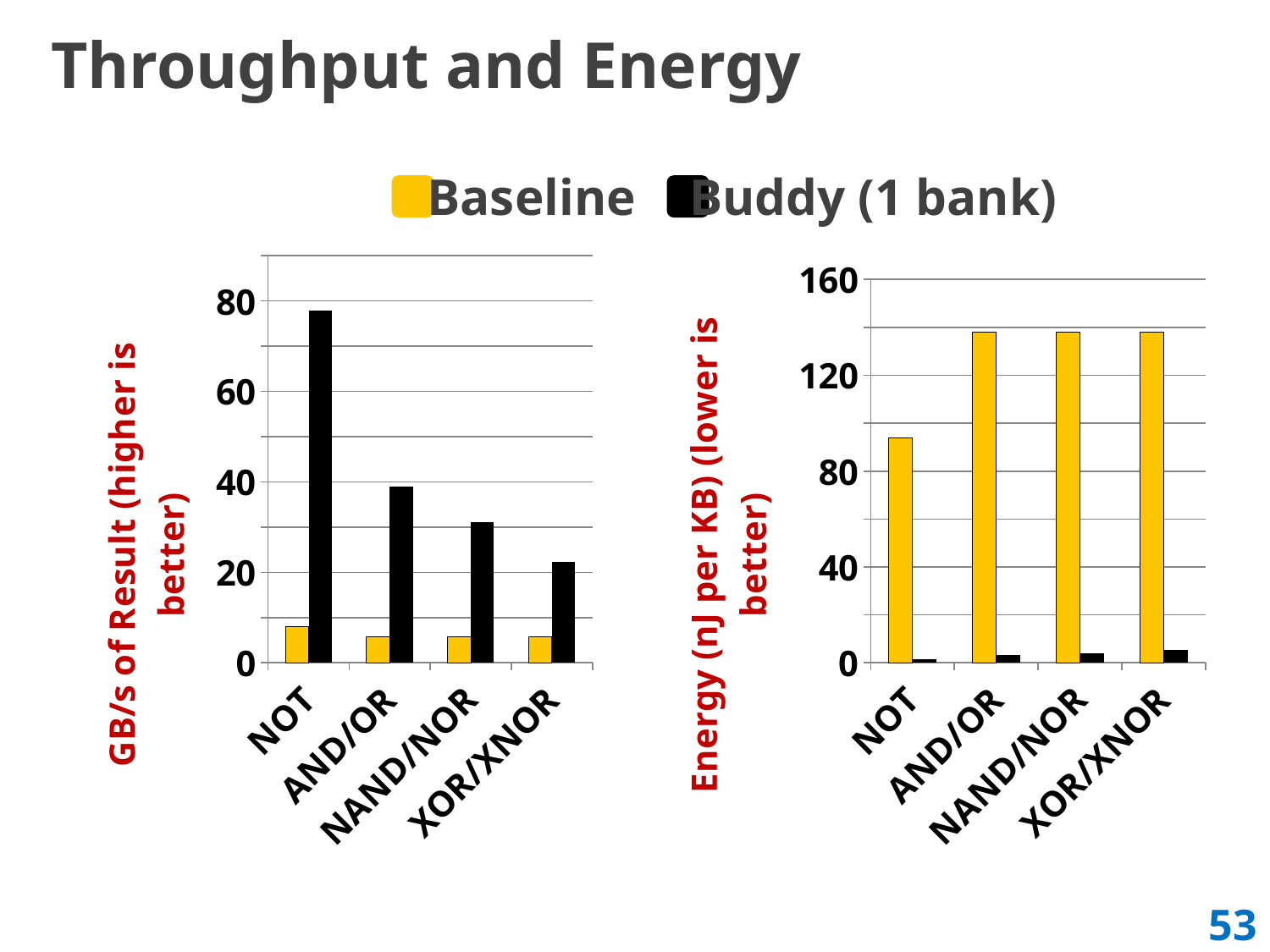
What kind of chart is the left chart (GB/s of Result)? bar chart How many series does the legend list? 2 In the left chart (GB/s of Result), is the Buddy (1 bank) value for XOR/XNOR greater or less than 40? less In the left chart (GB/s of Result), which category has the lowest Buddy (1 bank) value? XOR/XNOR In the right chart (Energy), is the Baseline value for NOT greater or less than 120? less In the right chart (Energy), which category has the lowest Baseline value? NOT In the right chart (Energy), which is larger for NAND/NOR: the Baseline value or the Buddy (1 bank) value? Baseline How many categories are shown on the x axis of the right chart (Energy)? 4 What colour represents the Buddy (1 bank) series in the legend? black In the left chart (GB/s of Result), which category has the highest Buddy (1 bank) value? NOT In the right chart (Energy), is the Baseline value for AND/OR greater or less than 120? greater